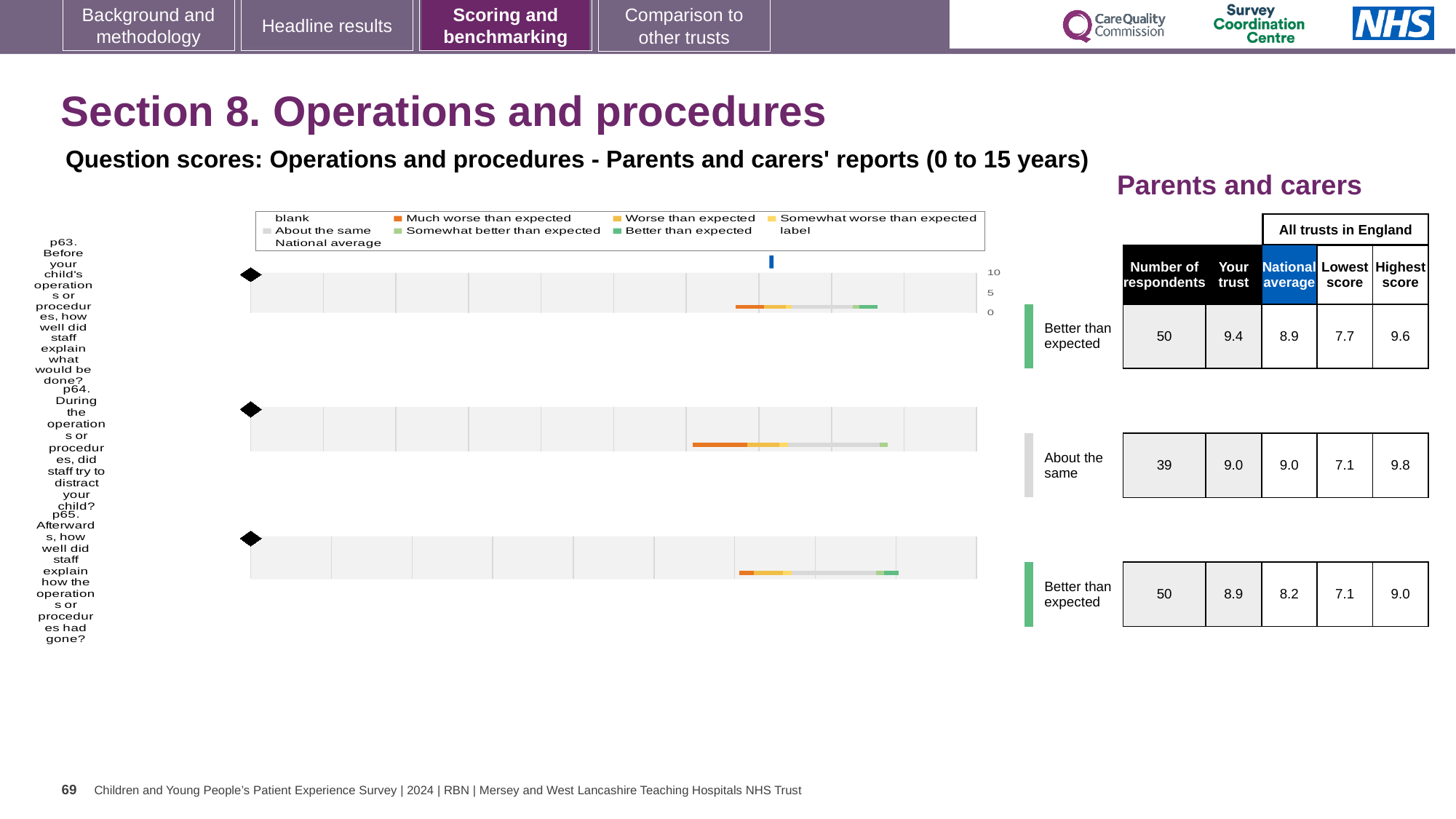
What is the highest score across all trusts in England for question p64? 9.8 What is the national average score for question p64 (During the operations or procedures, did staff try to distract your child?)? 9.0 What is the number of respondents for question p65 (Afterwards, how well did staff explain how the operations or procedures had gone?)? 50 What is the 'Your trust' score for question p63 (Before your child's operations or procedures, how well did staff explain what would be done?)? 9.4 What is the difference between the 'Your trust' score and the national average for question p65? 0.7 What is the lowest score across all trusts in England for question p63? 7.7 Which legend entry is shown in dark green? Better than expected Is the 'Your trust' score for question p63 higher or lower than the national average? higher How many questions are plotted on the slide? 3 Which question has the highest 'Your trust' score? p63 What benchmark category is shown for question p64? About the same Which question has the lowest 'Your trust' score? p65